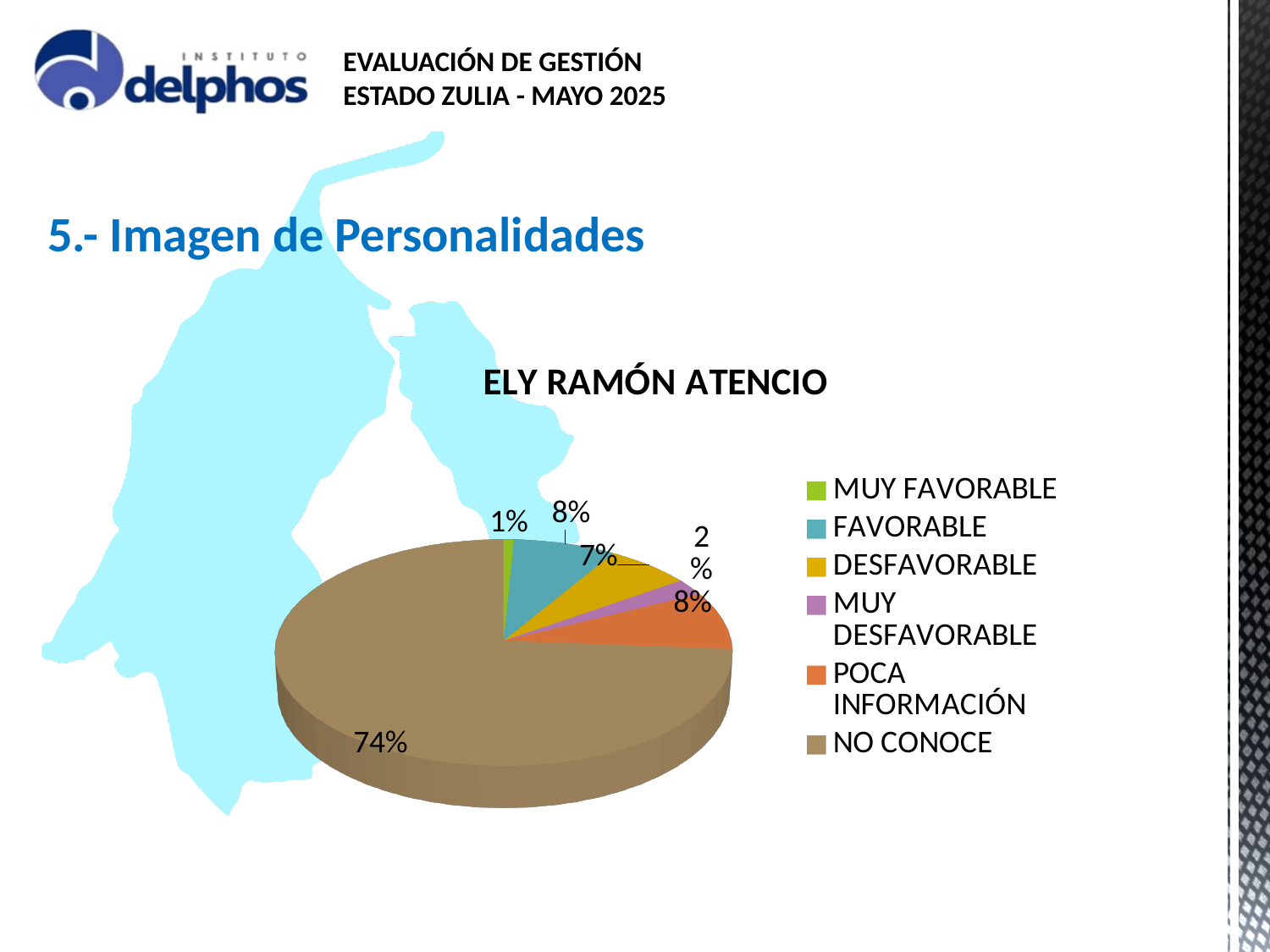
How many entries does the legend list? 6 Which is larger, the DESFAVORABLE slice or the MUY DESFAVORABLE slice? DESFAVORABLE What percentage does the DESFAVORABLE slice show? 7% Which category has the largest share of the pie chart? NO CONOCE What is the title of the chart? ELY RAMÓN ATENCIO What percentage of the pie chart is labelled NO CONOCE? 74% Which category has the smallest share of the pie chart? MUY FAVORABLE What is the value of the MUY DESFAVORABLE slice? 2% What is the difference between the NO CONOCE share and the FAVORABLE share? 66% How many slices does the pie chart have? 6 What is the value shown for the MUY FAVORABLE slice? 1% What kind of chart is shown on the slide? Pie chart